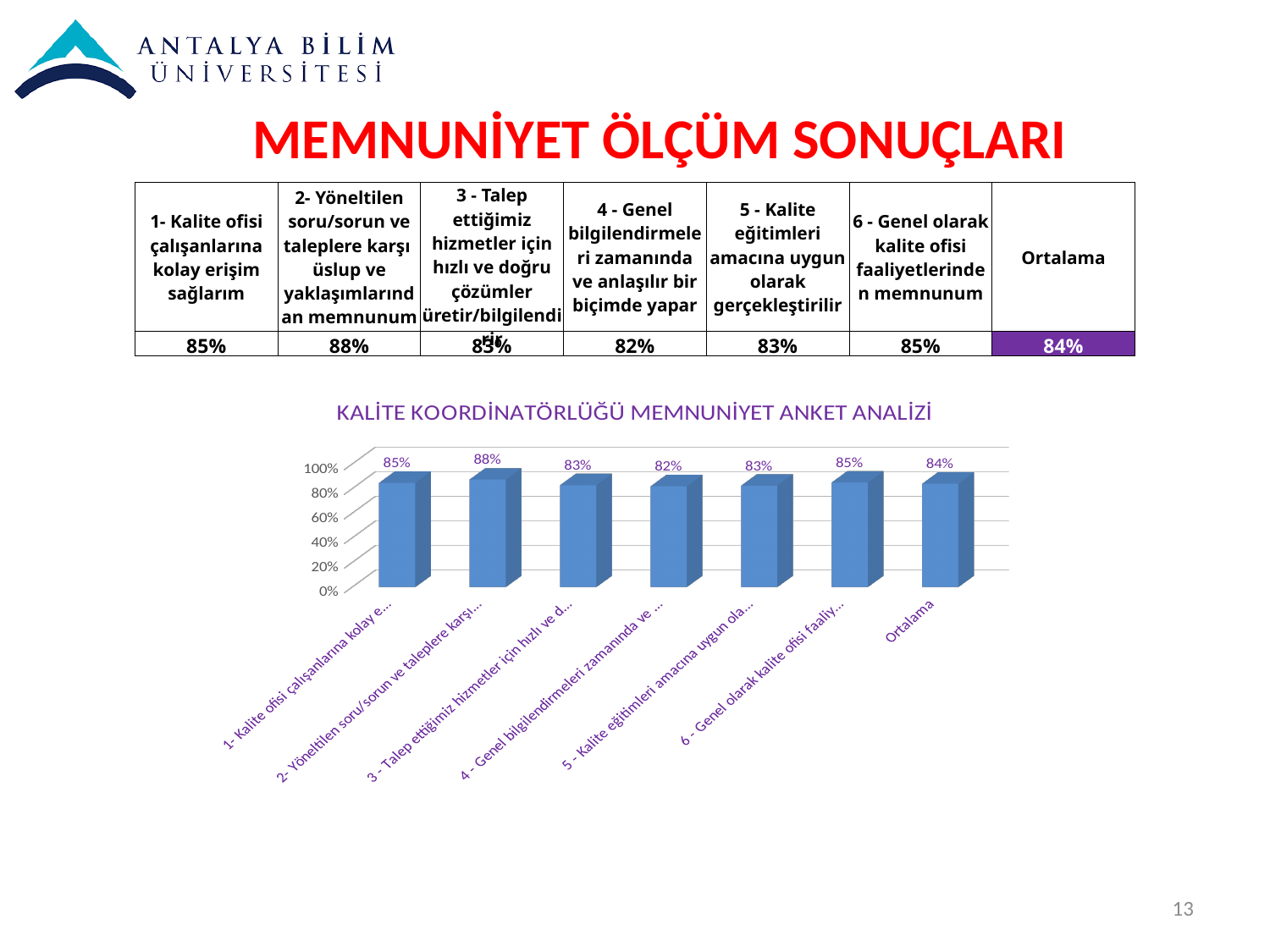
Which category has the highest value in the chart? 2- Yöneltilen soru/sorun ve taleplere karşı... Which is larger: the value for '1- Kalite ofisi çalışanlarına kolay e...' or the value for '3 - Talep ettiğimiz hizmetler için hızlı ve d...'? 1- Kalite ofisi çalışanlarına kolay e... What value is shown for the bar labelled '2- Yöneltilen soru/sorun ve taleplere karşı...'? 88% How many bars are plotted in the chart? 7 What type of chart is shown on the slide? Bar chart What is the value of the 'Ortalama' bar in the chart? 84% Is the value for '5 - Kalite eğitimleri amacına uygun ola...' greater or less than 60%? greater What is the title of the chart? KALİTE KOORDİNATÖRLÜĞÜ MEMNUNİYET ANKET ANALİZİ What is the difference between the highest bar (88%) and the lowest bar (82%)? 6 percentage points What is the difference between the value for '1- Kalite ofisi çalışanlarına kolay e...' and the 'Ortalama' value? 1 percentage point Which category has the lowest value in the chart? 4 - Genel bilgilendirmeleri zamanında ve ... What value is shown for the bar labelled '4 - Genel bilgilendirmeleri zamanında ve ...'? 82%